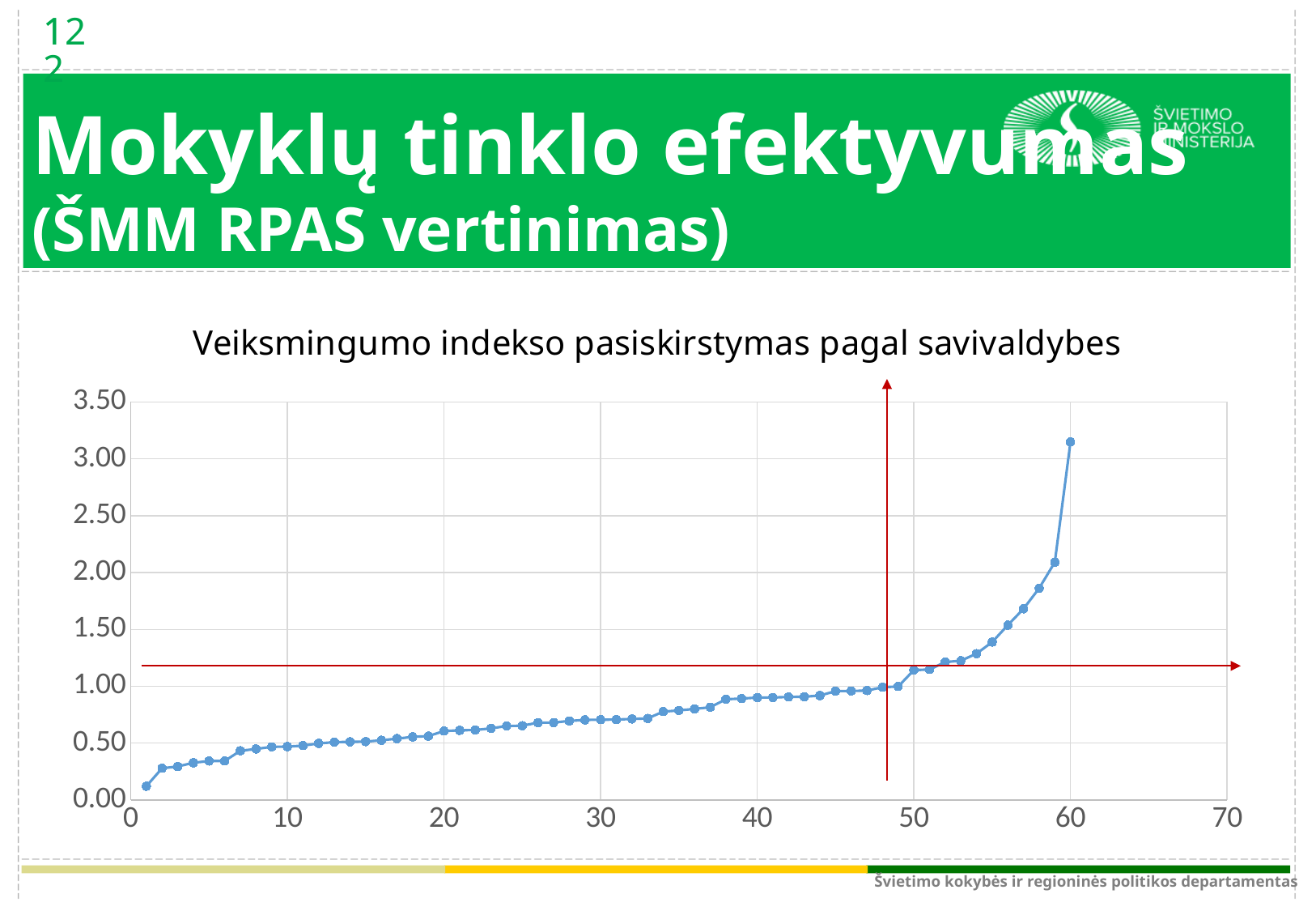
Is the value of the point at x = 30 greater or less than 0.50? greater Do the plotted values rise or fall as you move from left to right along the x axis? rise Is the value of the last point (at x = 60) greater or less than 3.00? greater Is the value of the point at x = 55 greater or less than 1.00? greater What kind of chart is shown on the slide? line chart What is the title of the chart? Veiksmingumo indekso pasiskirstymas pagal savivaldybes Which point has the highest value: the one at x = 60 or the one at x = 50? x = 60 How many data points are plotted on the chart? 60 What is the highest value shown on the y axis? 3.50